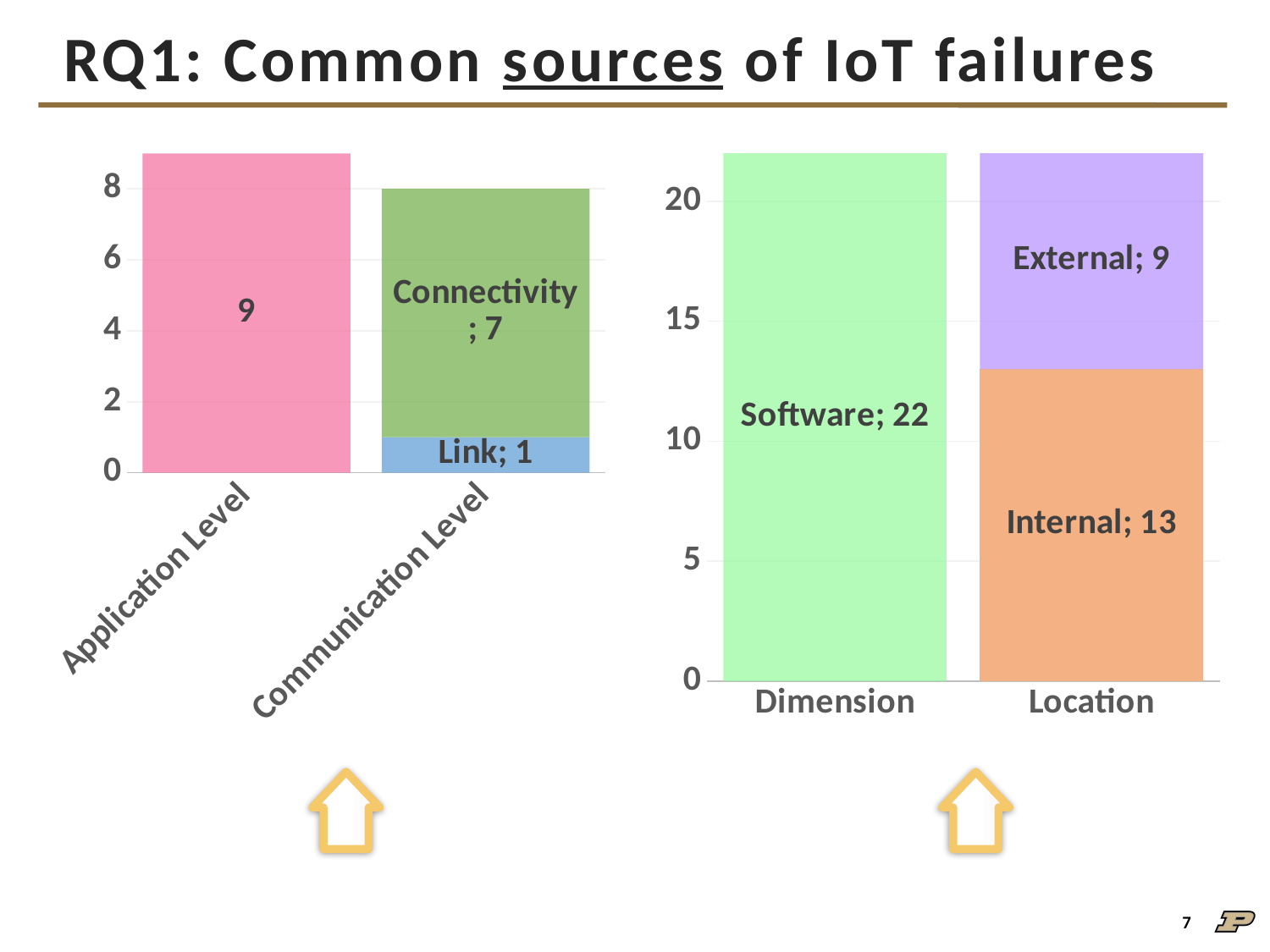
In the right chart, what is the value of the Internal segment in the Location bar? 13 In the left chart, what is the total of the stacked Communication Level bar? 8 In the left chart, what is the value of the Connectivity segment in the Communication Level bar? 7 In the left chart, how many categories are shown on the x axis? 2 In the left chart, what is the value of the Link segment in the Communication Level bar? 1 In the right chart, what is the value of the Software segment in the Dimension bar? 22 In the left chart, what is the value for Application Level? 9 In the right chart, which segment of the Location bar is larger, Internal or External? Internal In the right chart, what is the difference between the Internal and External segments of the Location bar? 4 In the right chart, what is the total of the stacked Location bar? 22 In the right chart, what is the value of the External segment in the Location bar? 9 In the left chart, what kind of chart is shown? Stacked bar chart